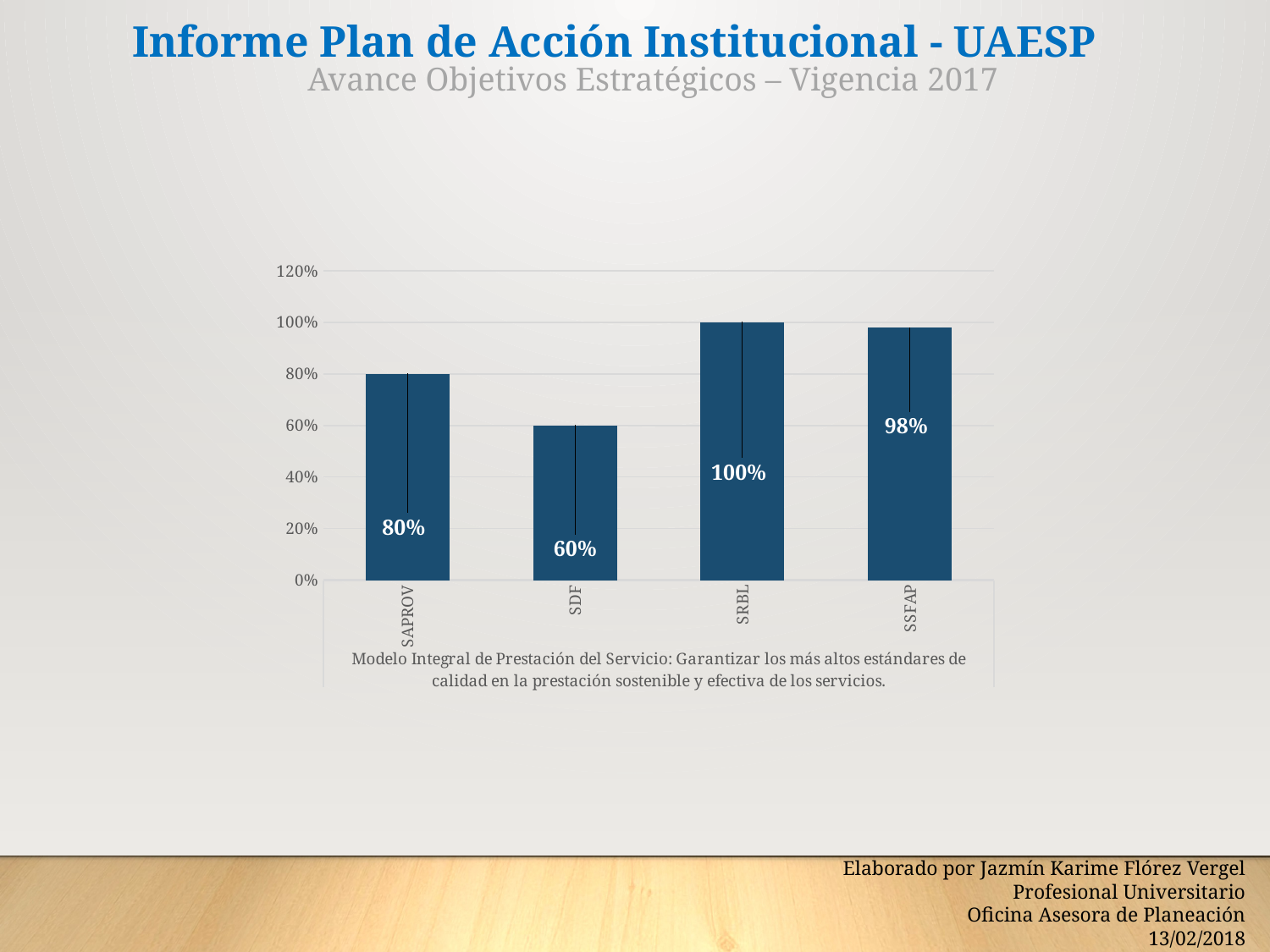
What is the difference between the values for SRBL and SSFAP? 2% How many categories are shown in the chart? 4 What is the difference between the values for SAPROV and SDF? 20% What is the value for SAPROV? 80% What is the value for SRBL? 100% Which category has the highest value? SRBL What kind of chart is shown on the slide? Bar chart What is the value for SSFAP? 98% What is the label shown below the category axis of the chart? Modelo Integral de Prestación del Servicio: Garantizar los más altos estándares de calidad en la prestación sostenible y efectiva de los servicios. What is the value for SDF? 60% Which category has the lowest value? SDF Which is larger, the value for SAPROV or the value for SSFAP? SSFAP